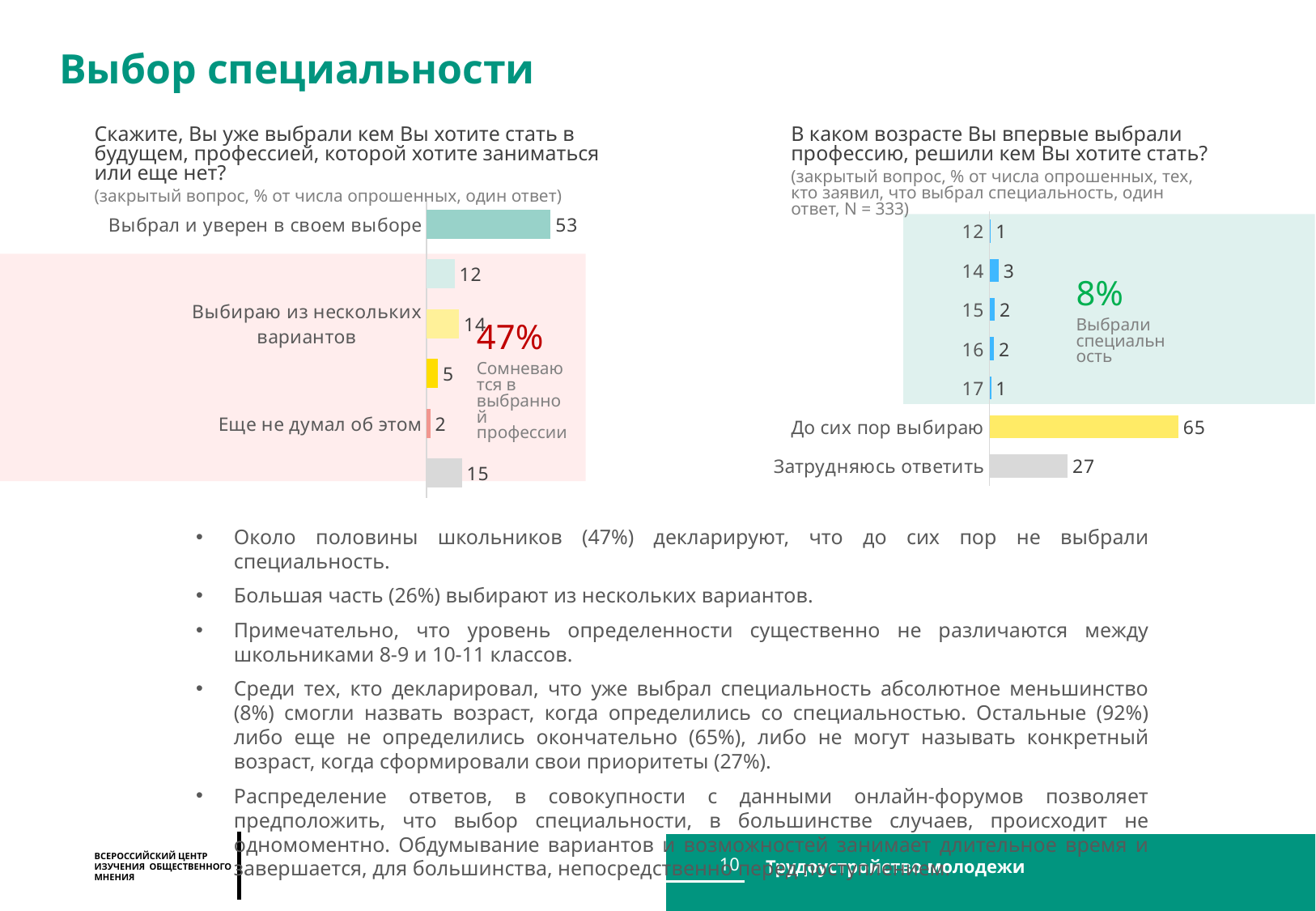
On the right chart, which category has the highest value? До сих пор выбираю What type of chart is the right chart? bar chart On the left chart, what is the difference between the value for "Выбрал и уверен в своем выборе" and the value for "Еще не думал об этом"? 51 On the right chart, what is the value for "Затрудняюсь ответить"? 27 On the right chart, which is larger: the value for age 14 or the value for age 16? age 14 On the left chart, what is the value for "Выбрал и уверен в своем выборе"? 53 On the left chart, which category has the highest value? Выбрал и уверен в своем выборе On the right chart, what is the value for age 17? 1 On the left chart, what is the value for "Еще не думал об этом"? 2 On the right chart, what is the value for "До сих пор выбираю"? 65 On the right chart, what is the difference between "До сих пор выбираю" and "Затрудняюсь ответить"? 38 On the right chart, what is the value for age 14? 3